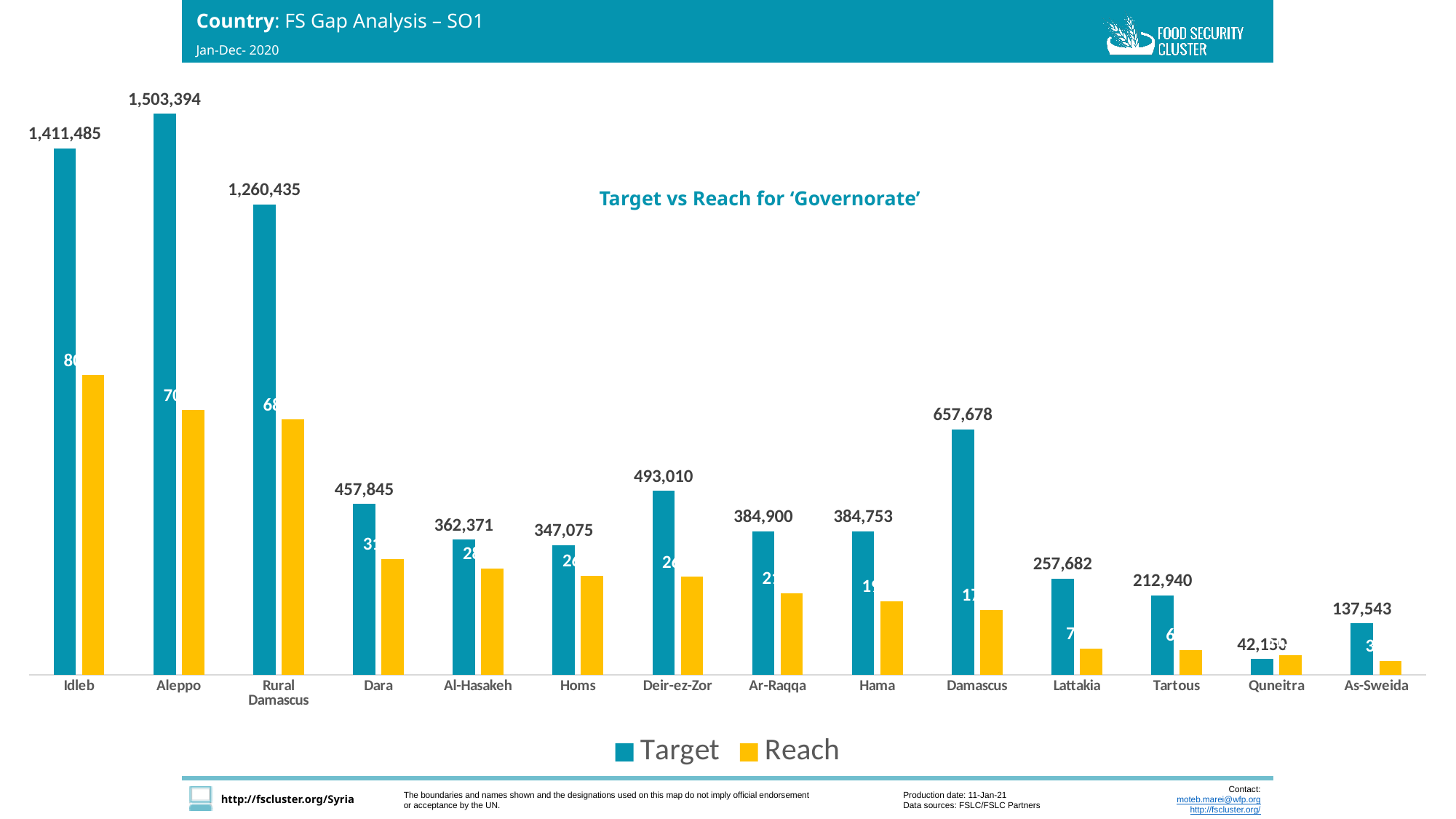
For Deir-ez-Zor, which is larger, the Target bar or the Reach bar? Target Which governorate has the highest Target value? Aleppo What is the Target value for Idleb? 1,411,485 How many series does the legend list? 2 Which has the larger Target value, Dara or Al-Hasakeh? Dara What is the difference between the Target values for Damascus and Lattakia? 399,996 Which governorate has the lowest Target value? Quneitra What is the Target value for Quneitra? 42,150 What is the Target value for Damascus? 657,678 What is the difference between the Target values for Aleppo and Idleb? 91,909 How many governorates are shown on the x axis? 14 What type of chart is shown? Bar chart